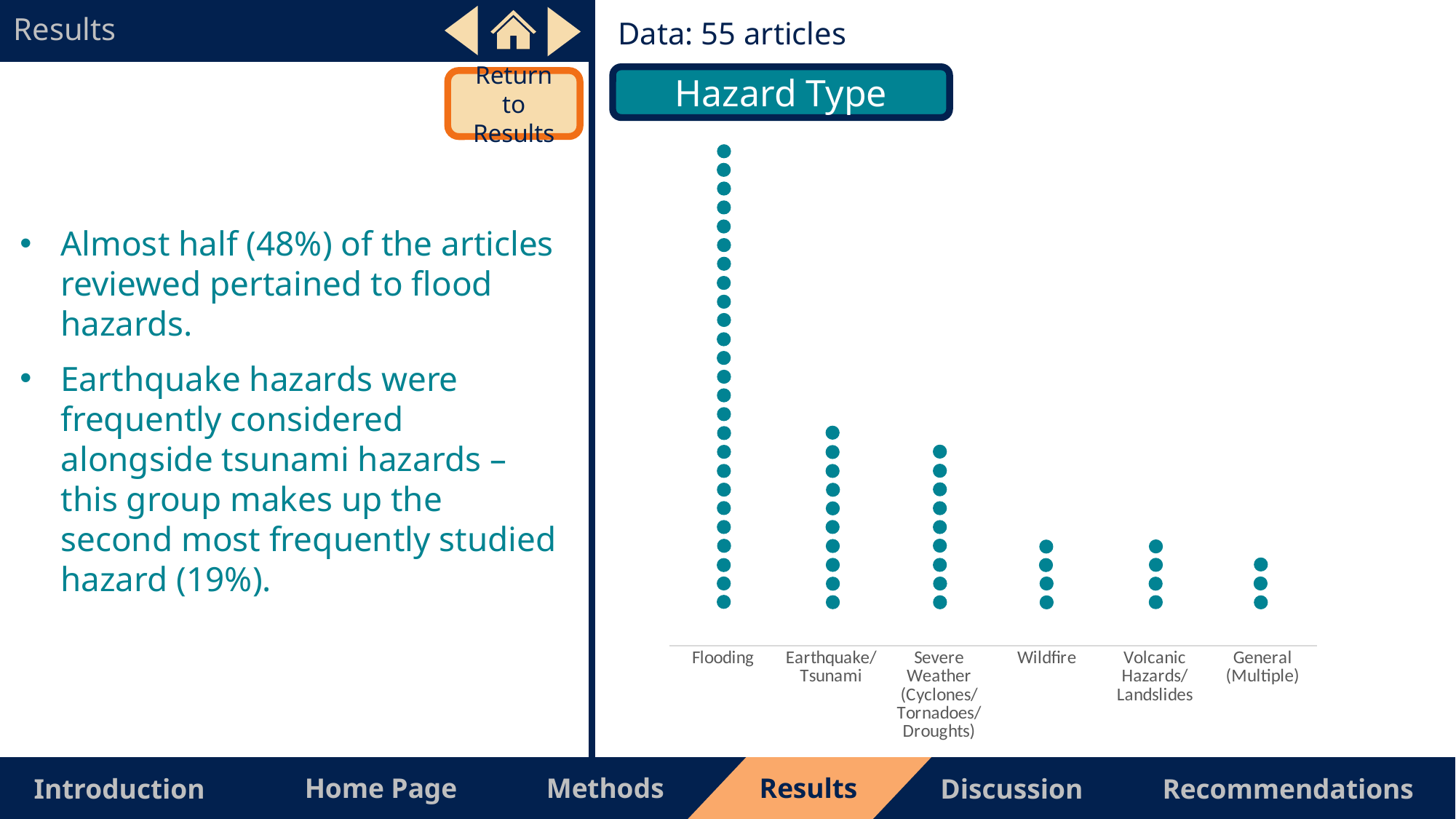
Do the values in the chart generally rise or fall from left to right along the x axis? Fall Which hazard type has the highest number of articles in the chart? Flooding How many articles make up the data set shown in the chart, according to the slide? 55 articles Which has more articles in the chart, Earthquake/Tsunami or General (Multiple)? Earthquake/Tsunami What is the title of the chart? Hazard Type Which has more articles in the chart, Severe Weather (Cyclones/Tornadoes/Droughts) or Wildfire? Severe Weather (Cyclones/Tornadoes/Droughts) Which has more articles in the chart, Flooding or Earthquake/Tsunami? Flooding Which hazard type has the lowest number of articles in the chart? General (Multiple) What kind of chart is shown on the slide? Dot plot How many hazard type categories are shown on the x axis of the chart? 6